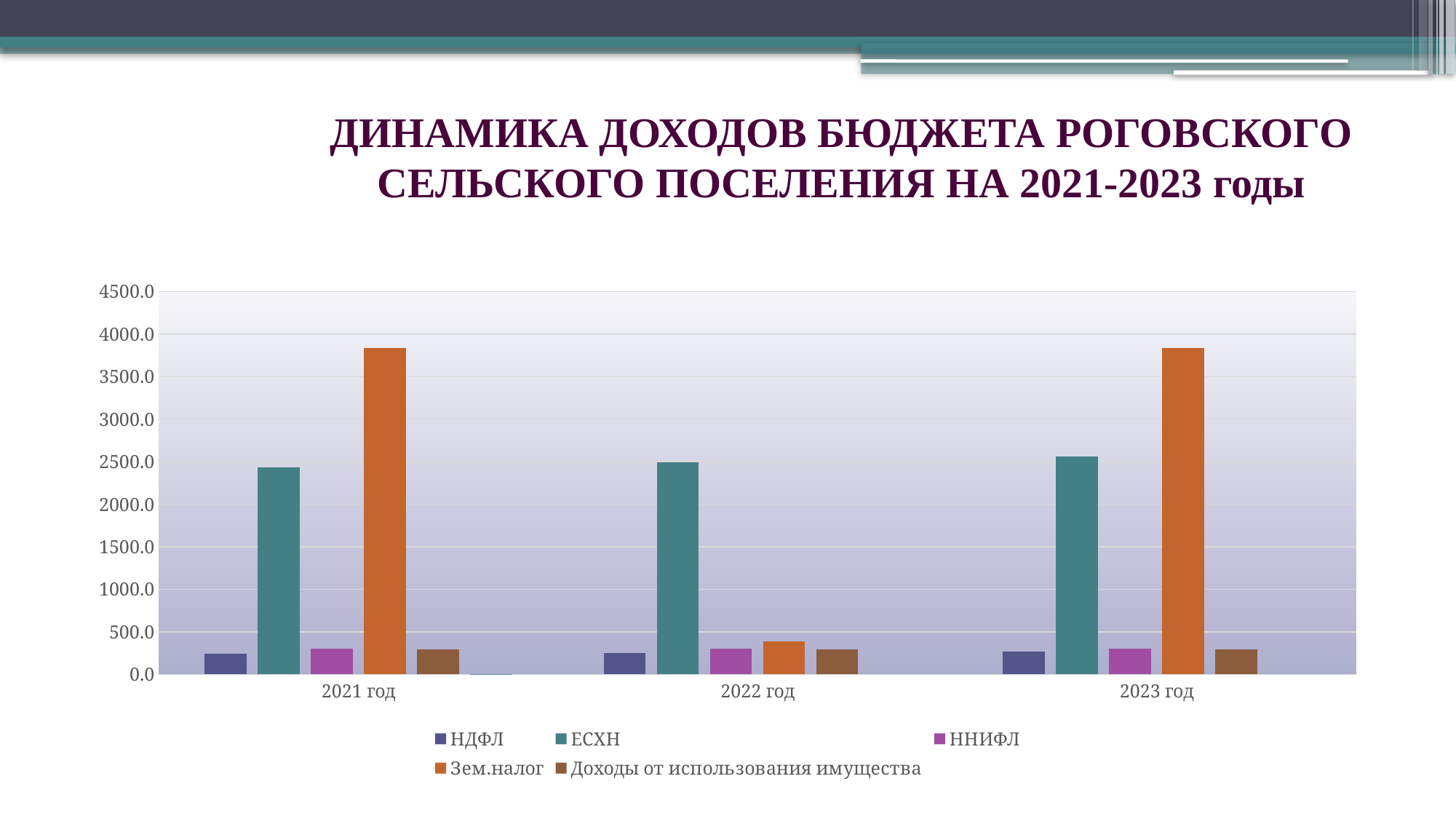
Is the value for Зем.налог in 2021 год greater or less than 3500? greater Which is larger: Зем.налог in 2021 год or Зем.налог in 2022 год? 2021 год Which series has the highest value in 2022 год? ЕСХН Is the value for НДФЛ in 2023 год greater or less than 500? less How many series does the legend list? 5 Which colour represents Зем.налог in the legend? orange How many year categories are shown on the x axis? 3 Is the value for ЕСХН in 2021 год greater or less than 2000? greater Which series has the highest value in 2023 год? Зем.налог Which series has the highest value in 2021 год? Зем.налог What kind of chart is shown on the slide? bar chart